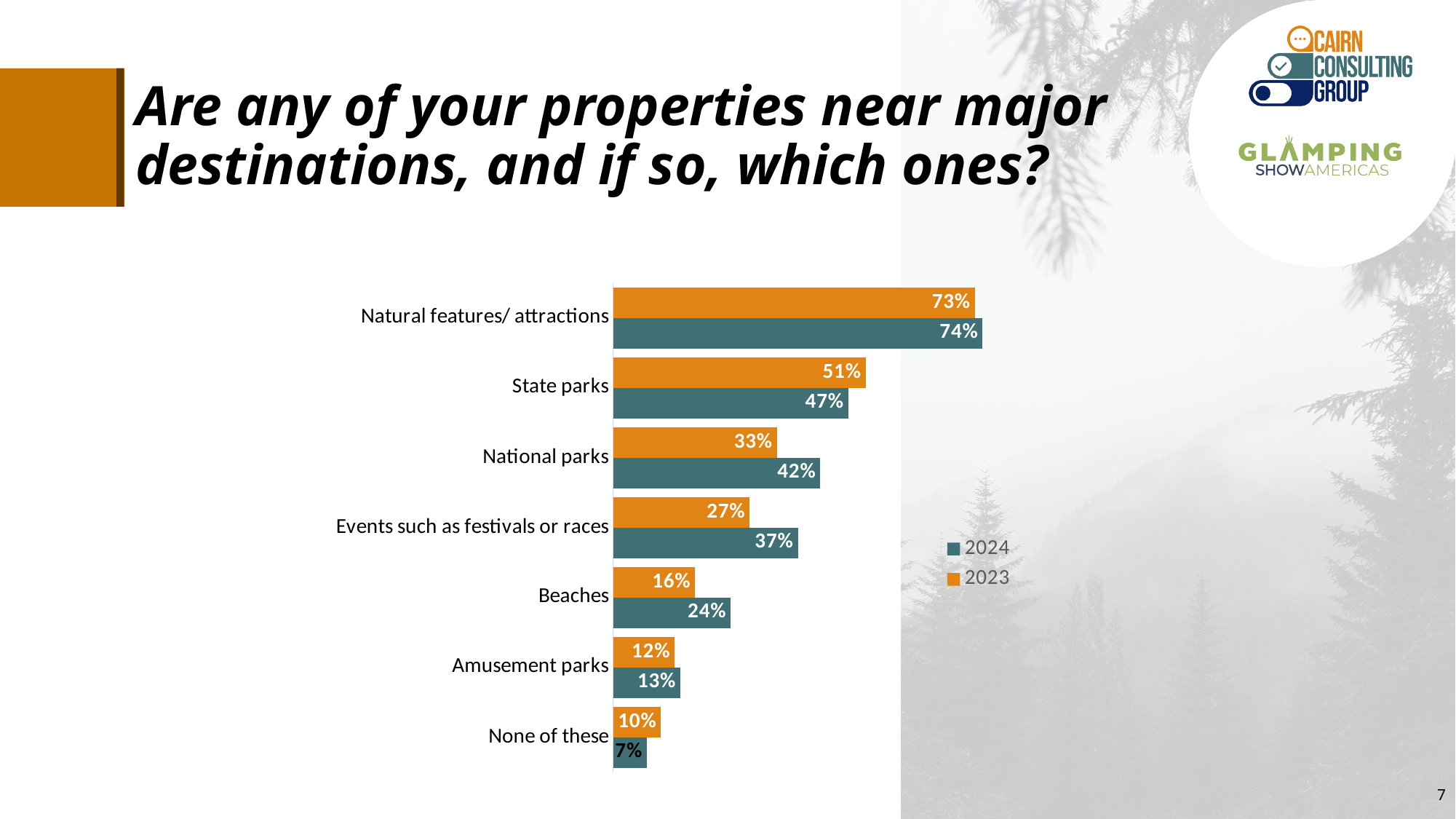
What is the 2024 value for Events such as festivals or races? 37% How many series does the legend list? 2 What is the 2023 value for Beaches? 16% What kind of chart is shown on the slide? Bar chart Which category has the highest 2024 value? Natural features/ attractions Which is larger for National parks, the 2023 value or the 2024 value? 2024 What is the difference between the 2023 and 2024 values for State parks? 4% Which category has the lowest 2024 value? None of these Which colour represents the 2023 series? Orange What is the 2024 value for National parks? 42% What is the difference between the 2024 and 2023 values for Events such as festivals or races? 10% How many categories are shown on the chart? 7